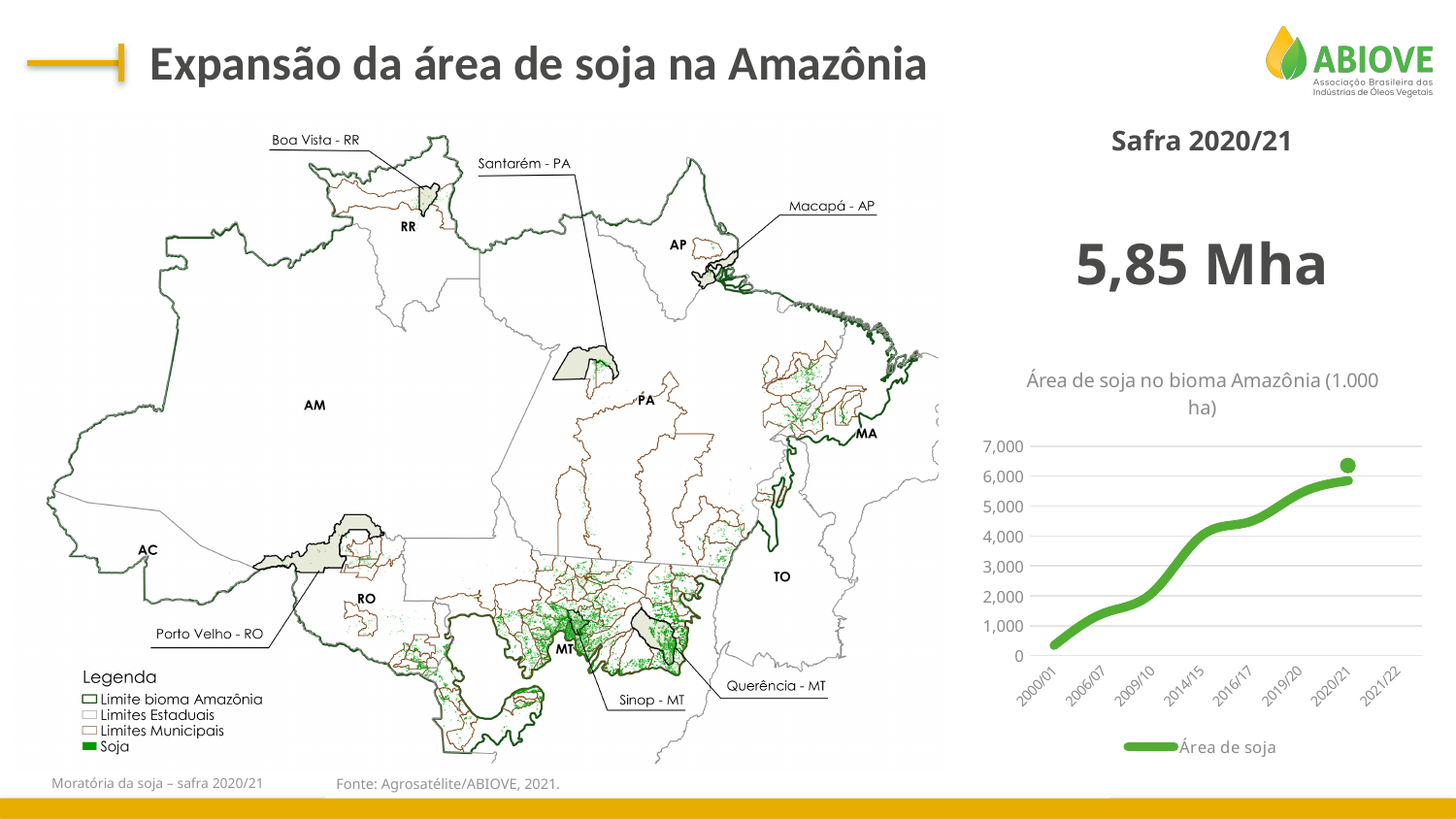
What is the title of the chart on the right side of the slide? Área de soja no bioma Amazônia (1.000 ha) Do the values in the line chart rise or fall from 2000/01 to 2020/21? rise How many labels are shown on the x axis of the line chart? 8 In the line chart, is the value for 2016/17 greater or less than 4,000? greater Which x-axis category has the lowest value in the line chart? 2000/01 Which x-axis category has the highest plotted value in the line chart? 2020/21 In the line chart, is the value for 2006/07 greater or less than 2,000? less In the line chart, is the value for 2020/21 greater or less than 5,000? greater What kind of chart is shown on the right side of the slide? line chart What is the name of the series in the line chart's legend? Área de soja How many series does the legend of the line chart list? 1